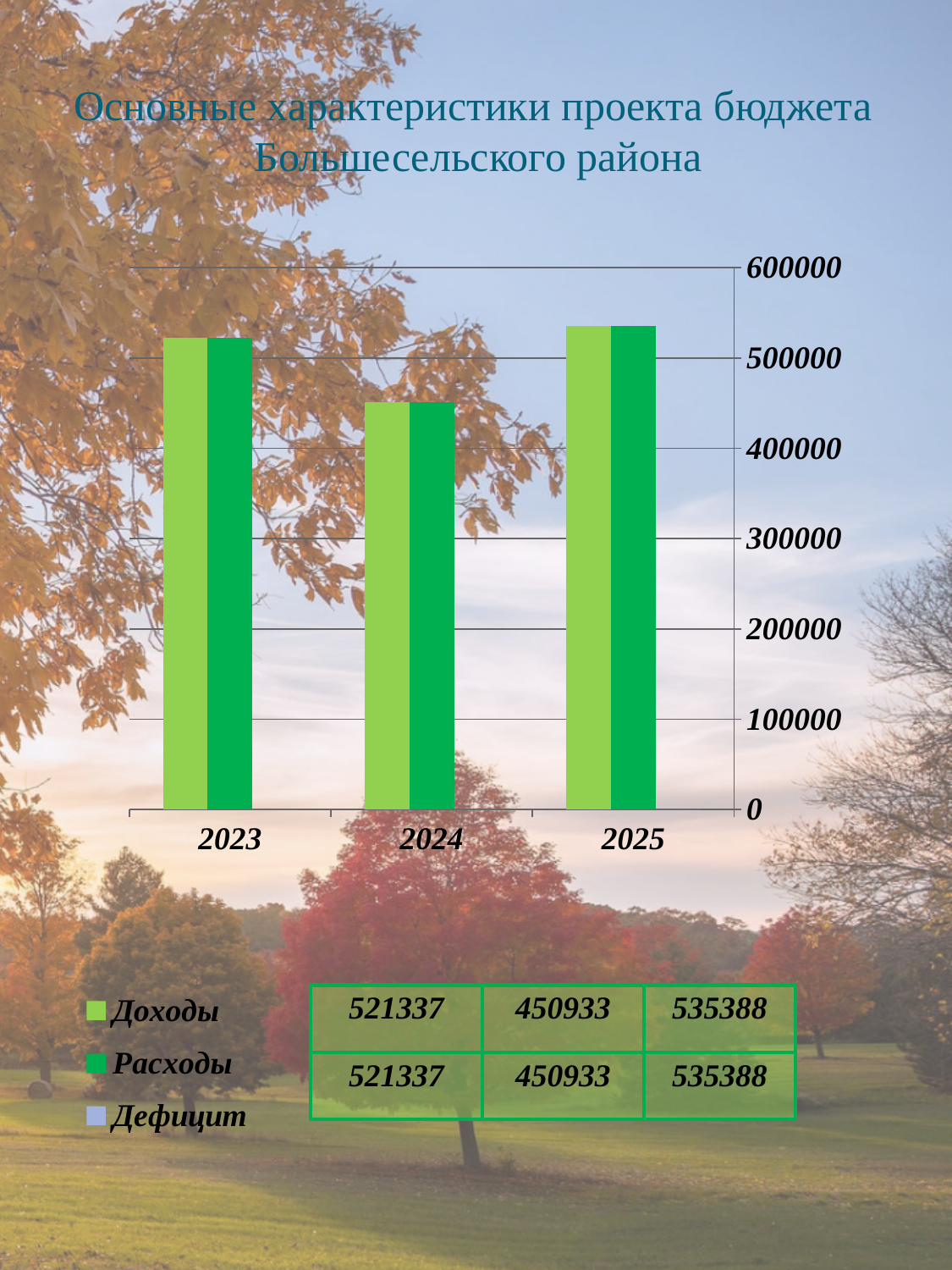
What is the value of Расходы for 2025? 535388 How many years are shown on the x axis of the chart? 3 Which is larger: Доходы in 2023 or Доходы in 2025? 2025 What is the value of Доходы for 2024? 450933 What is the difference between Доходы in 2025 and Доходы in 2024? 84455 How many series does the legend list? 3 What type of chart is shown on the slide? bar chart Which year has the highest value for Доходы? 2025 What is the value of Доходы for 2023? 521337 Which year has the lowest value for Расходы? 2024 What is the title of the slide containing the chart? Основные характеристики проекта бюджета Большесельского района Is the value for Расходы in 2024 greater or less than 500000? less